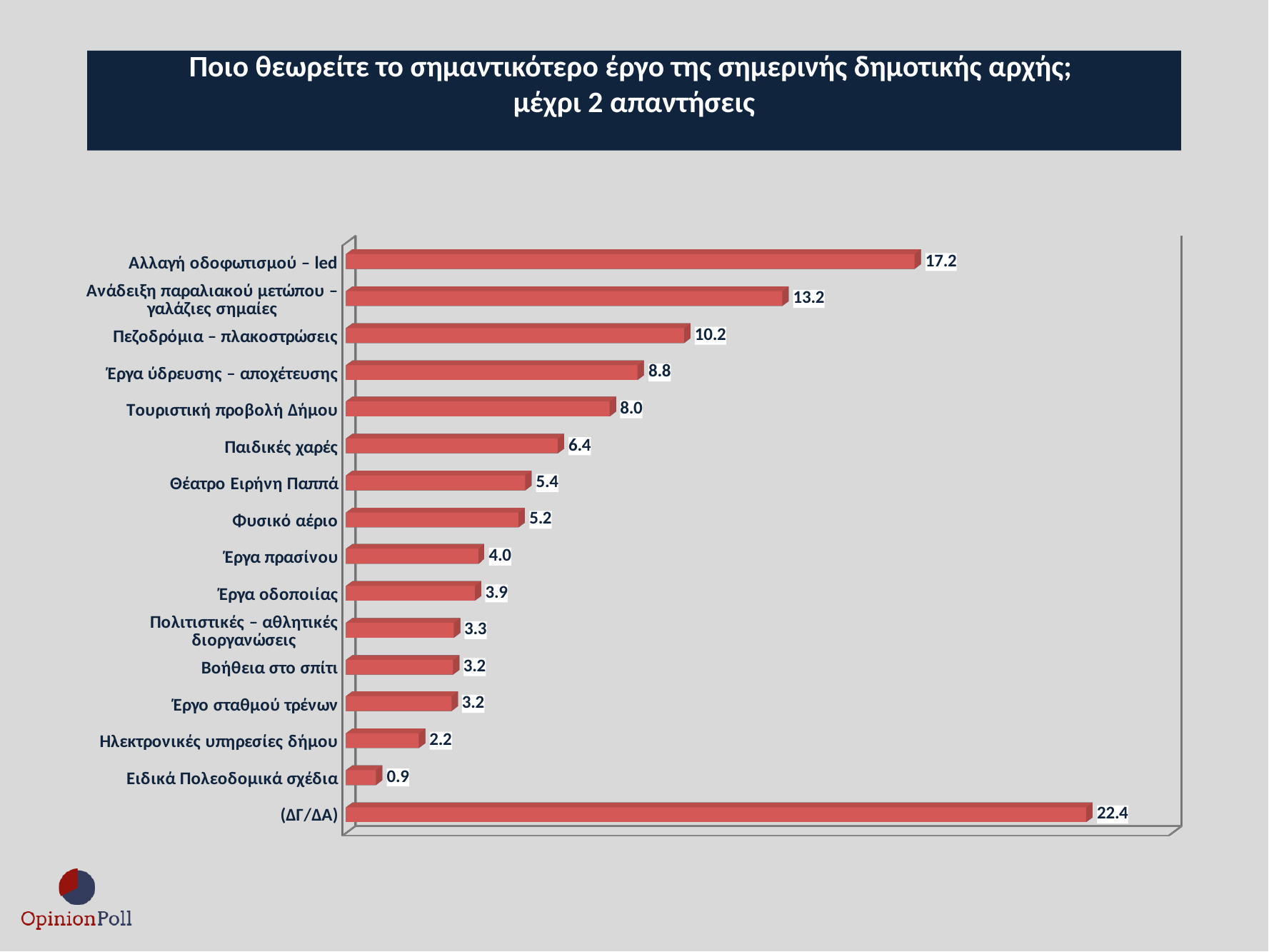
Which has a larger value, Παιδικές χαρές or Θέατρο Ειρήνη Παππά? Παιδικές χαρές What is the title of the chart? Ποιο θεωρείτε το σημαντικότερο έργο της σημερινής δημοτικής αρχής; μέχρι 2 απαντήσεις How many categories are shown in the chart? 16 What value is shown for Αλλαγή οδοφωτισμού – led? 17.2 Which category has the highest value in the chart? (ΔΓ/ΔΑ) Which category has the lowest value in the chart? Ειδικά Πολεοδομικά σχέδια What is the difference between the values for Έργα ύδρευσης – αποχέτευσης and Τουριστική προβολή Δήμου? 0.8 What value is shown for Ηλεκτρονικές υπηρεσίες δήμου? 2.2 What is the difference between the values for Αλλαγή οδοφωτισμού – led and Ανάδειξη παραλιακού μετώπου – γαλάζιες σημαίες? 4.0 What value is shown for Φυσικό αέριο? 5.2 What kind of chart is shown on the slide? Bar chart What value is shown for Πεζοδρόμια – πλακοστρώσεις? 10.2